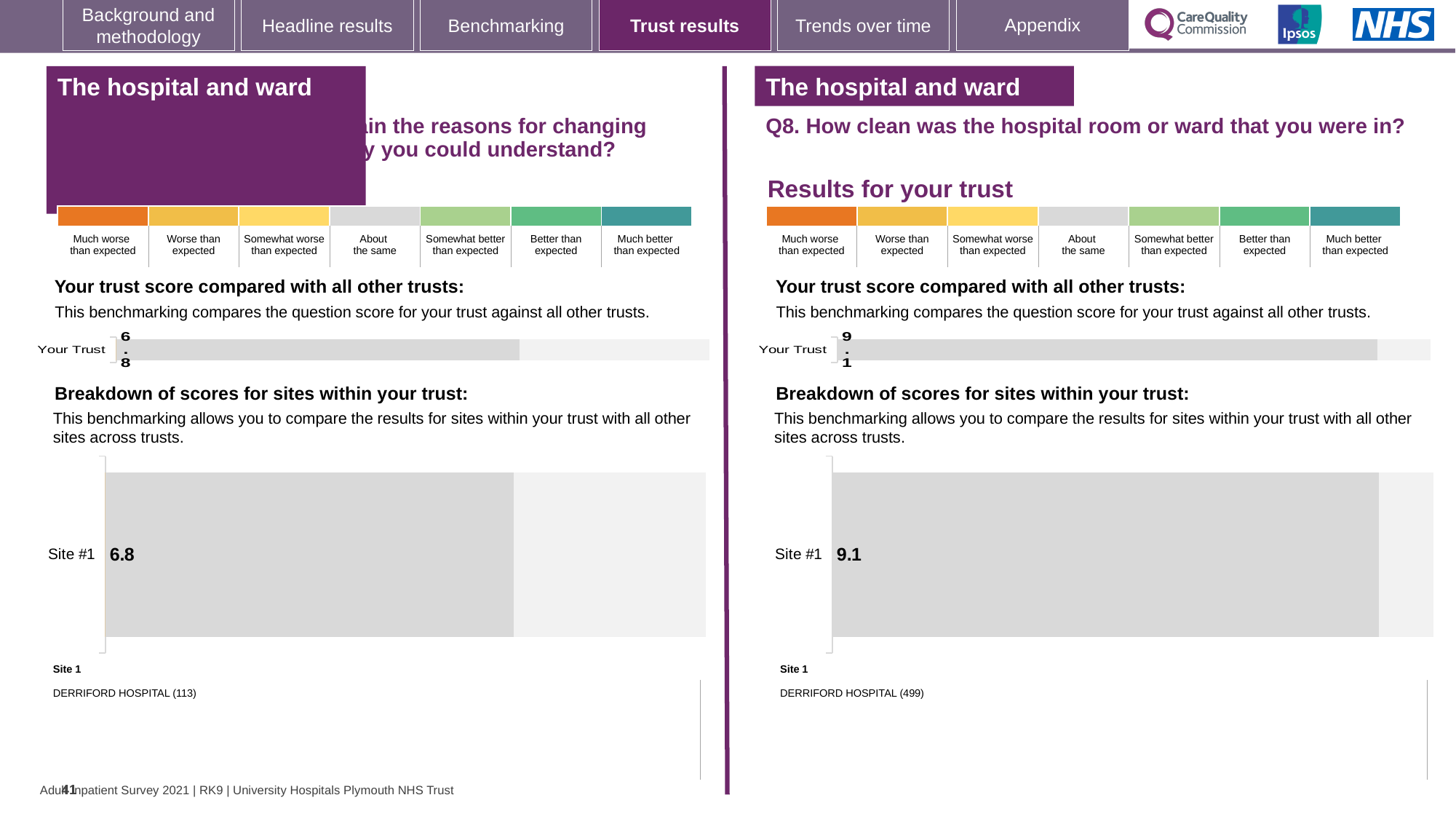
On the right-hand chart for Q8, which site is listed as Site 1? DERRIFORD HOSPITAL (499) What kind of chart is used to show the Site #1 score on the right-hand chart for Q8? Bar chart On the right-hand chart for Q8, is the Your Trust score the same as the Site #1 score? Yes What is the difference between the Site #1 score on the right-hand chart for Q8 and the Site #1 score on the left-hand chart? 2.3 On the left-hand chart, which site is listed as Site 1? DERRIFORD HOSPITAL (113) Which is larger: the Site #1 score on the left-hand chart or the Site #1 score on the right-hand chart for Q8? Right-hand chart (Q8) On the left-hand chart of the slide, what is the score shown for Your Trust? 6.8 On the left-hand chart of the slide, what is the score shown for Site #1? 6.8 On the right-hand chart for Q8 (How clean was the hospital room or ward that you were in?), what is the score shown for Your Trust? 9.1 How many sites are shown in the breakdown of scores on the right-hand chart for Q8? 1 On the right-hand chart for Q8, what is the score shown for Site #1? 9.1 How many sites are shown in the breakdown of scores on the left-hand chart? 1